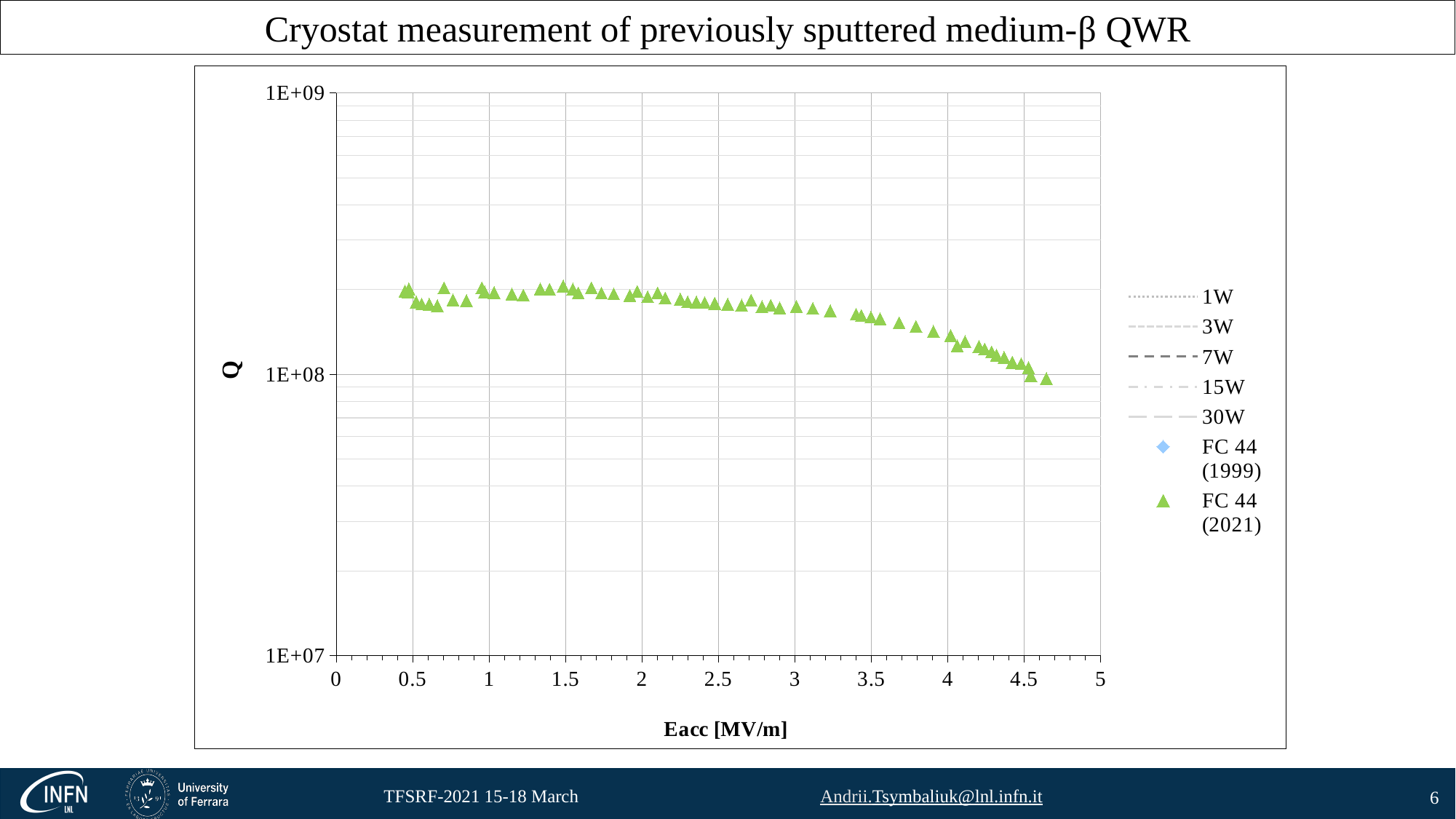
Is the Q value at Eacc = 3 MV/m greater or less than 1E+08? greater Does the plotted Q value rise or fall as Eacc increases from 1.5 to 4.5 MV/m? Fall Is the Q value at Eacc = 1 MV/m greater or less than 1E+08? greater Is the Q value at Eacc = 1.5 MV/m greater or less than 1E+09? less What is the title of the slide containing the chart? Cryostat measurement of previously sputtered medium-β QWR What kind of chart is shown on the slide? Scatter chart Which has the larger Q value: the point at Eacc = 1.5 MV/m or the point at Eacc = 4.5 MV/m? Eacc = 1.5 MV/m Which has the larger Q value: the point at Eacc = 1 MV/m or the point at Eacc = 4 MV/m? Eacc = 1 MV/m Which legend series is plotted with green triangles? FC 44 (2021) How many series does the chart legend list? 7